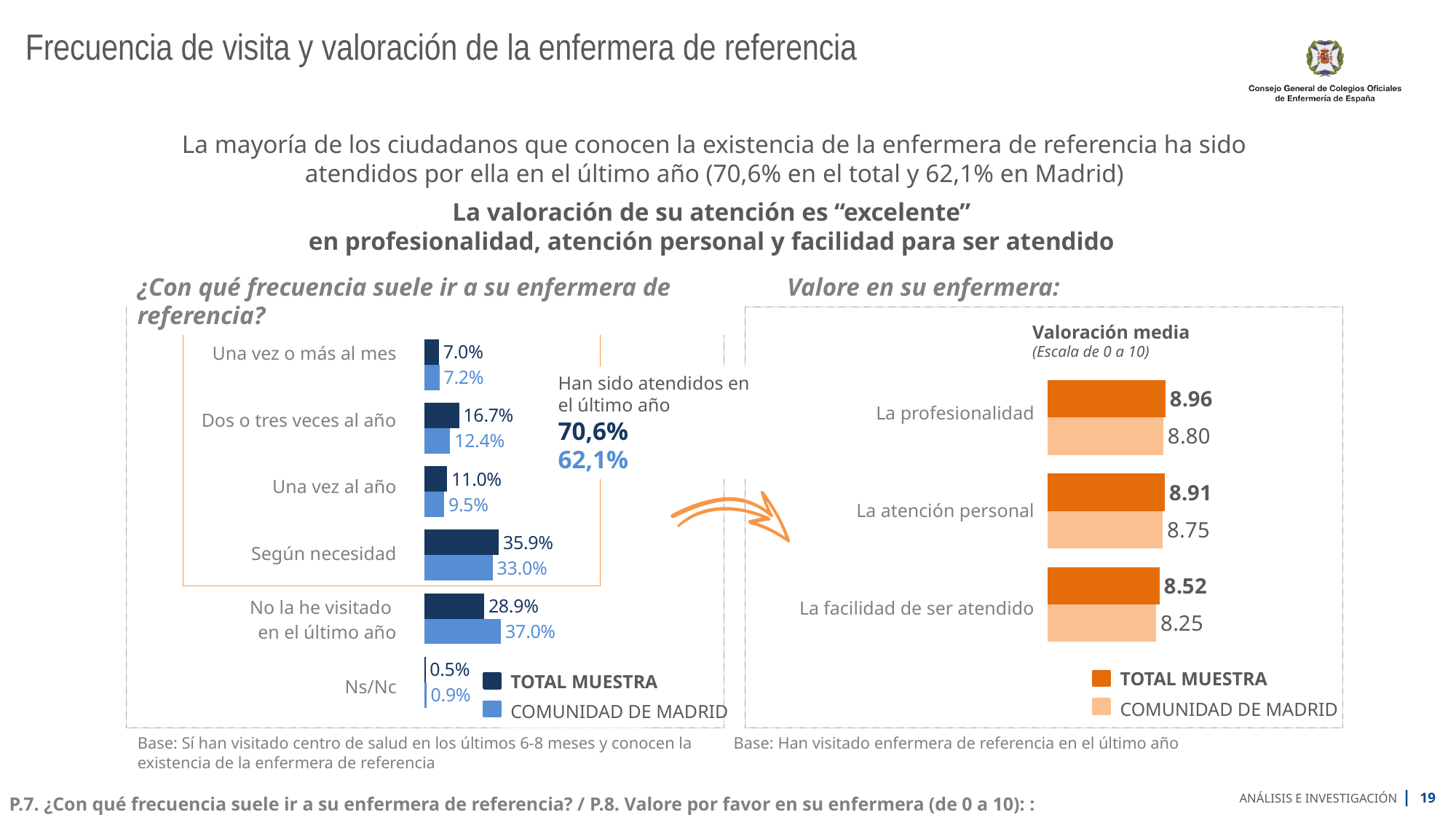
In the right chart 'Valoración media', which item has the lowest COMUNIDAD DE MADRID score? La facilidad de ser atendido What type of chart is the right chart 'Valoración media'? Bar chart In the right chart 'Valoración media', what is the difference between the TOTAL MUESTRA and COMUNIDAD DE MADRID scores for 'La facilidad de ser atendido'? 0.27 In the left chart on visit frequency, what is the COMUNIDAD DE MADRID value for 'No la he visitado en el último año'? 37.0% In the left chart on visit frequency, for 'No la he visitado en el último año', which series has the larger value: TOTAL MUESTRA or COMUNIDAD DE MADRID? COMUNIDAD DE MADRID How many categories does the left chart on visit frequency show? 6 In the right chart 'Valoración media', what is the TOTAL MUESTRA score for 'La atención personal'? 8.91 In the left chart on visit frequency, which category has the highest TOTAL MUESTRA value? Según necesidad In the left chart on visit frequency, which category has the lowest COMUNIDAD DE MADRID value? Ns/Nc In the left chart on visit frequency, what is the difference between the TOTAL MUESTRA and COMUNIDAD DE MADRID values for 'Dos o tres veces al año'? 4.3% In the left chart on visit frequency, what is the TOTAL MUESTRA value for 'Según necesidad'? 35.9% How many series does the legend of the right chart 'Valoración media' list? 2